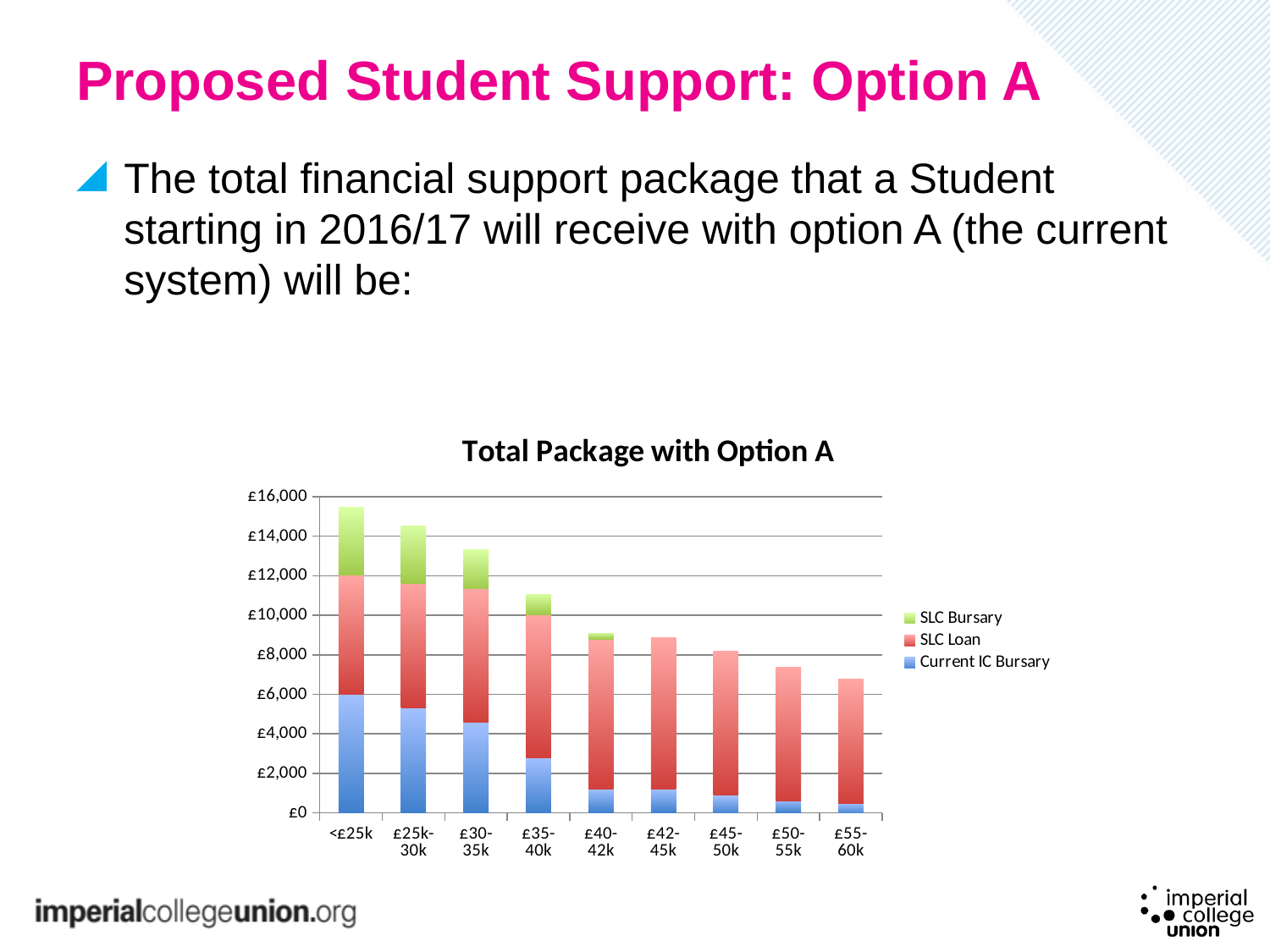
Which income band has the highest total package? <£25k How many income bands are shown on the x axis? 9 What is the title of the chart? Total Package with Option A How many series does the legend list? 3 Do the total package values rise or fall as household income increases along the x axis? fall Which has the larger total package, £25k-30k or £42-45k? £25k-30k What kind of chart is shown on the slide? stacked bar chart Is the total package for <£25k greater or less than £14,000? greater Is the Current IC Bursary for £30-35k greater or less than £4,000? greater Is the total package for £55-60k greater or less than £8,000? less Which income band has the lowest total package? £55-60k Which series is shown in green in the legend? SLC Bursary